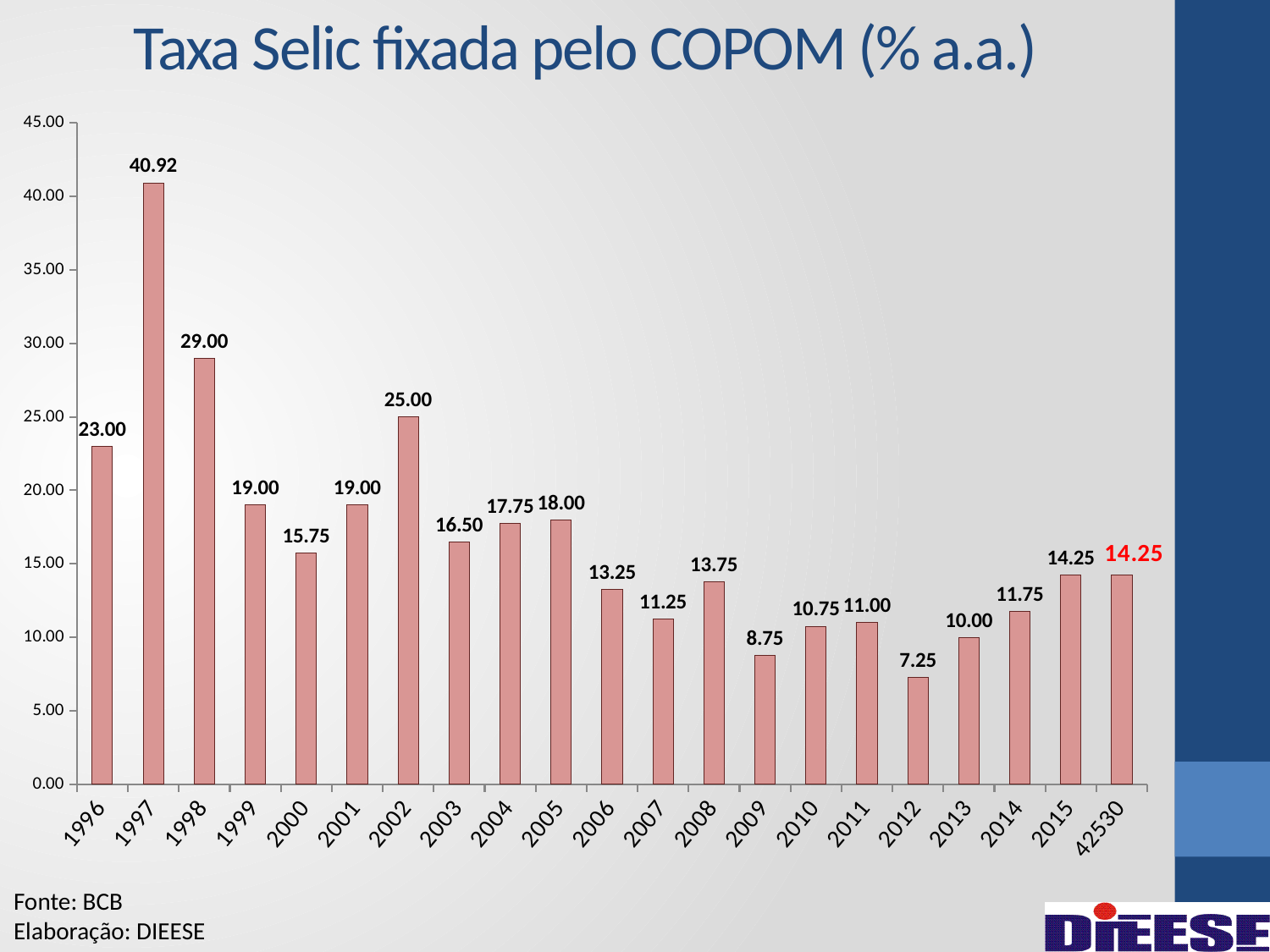
Is the value for 2000 greater or less than 15.00? greater Which year has the highest value? 1997 How many bars are shown in the chart? 21 What is the title of the chart? Taxa Selic fixada pelo COPOM (% a.a.) What kind of chart is shown on the slide? Bar chart What is the value for 2009? 8.75 Which is larger, the value for 2006 or the value for 2008? 2008 What is the value for 1997? 40.92 What is the difference between the values for 1998 and 1999? 10.00 What is the value for 2012? 7.25 What is the value for 2002? 25.00 Which year has the lowest value? 2012